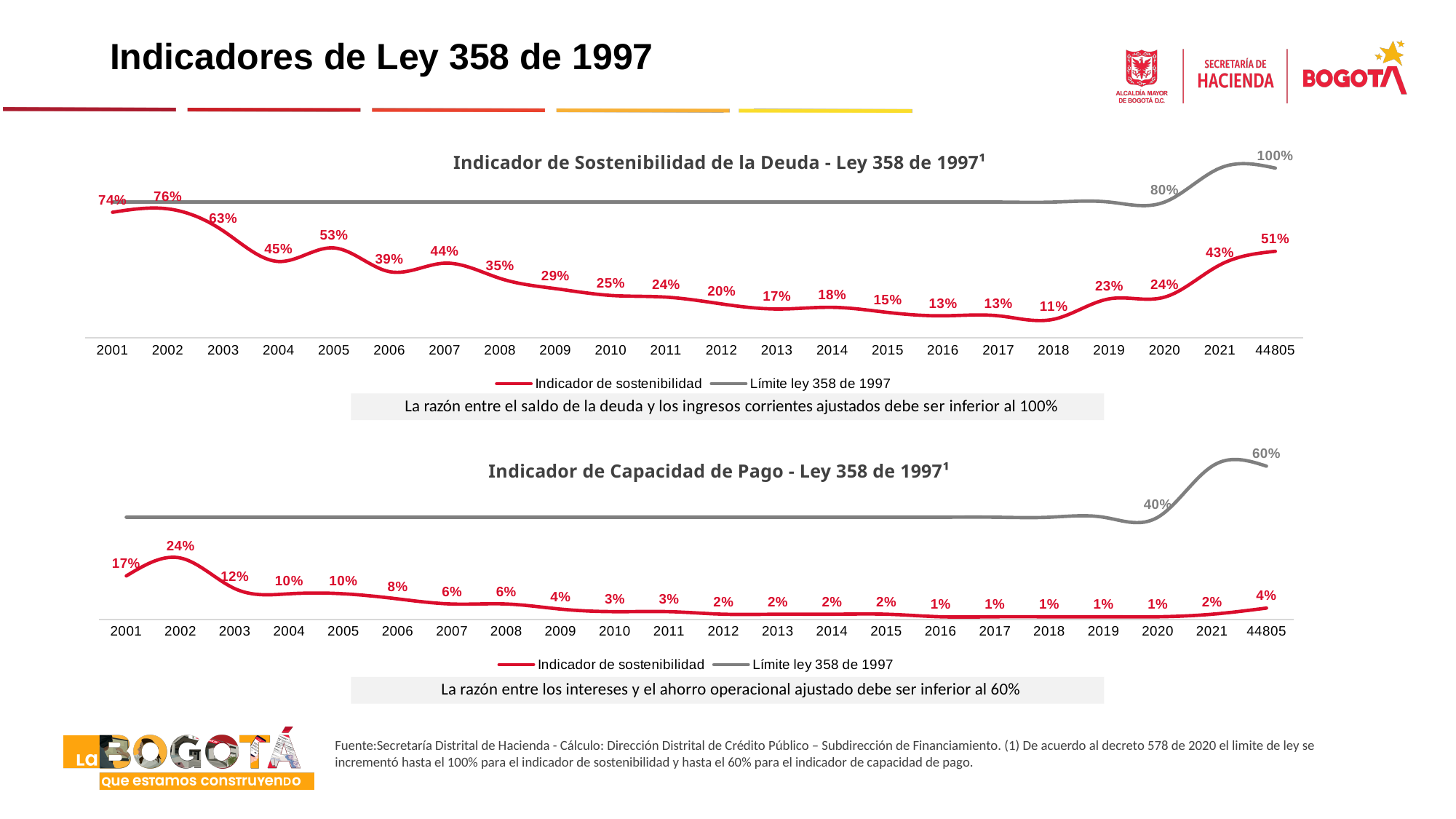
In the 'Indicador de Sostenibilidad de la Deuda' chart, which year has the lowest Indicador de sostenibilidad value? 2018 In the 'Indicador de Capacidad de Pago' chart, which is larger, the Indicador de sostenibilidad value for 2003 or for 2006? 2003 In the 'Indicador de Sostenibilidad de la Deuda' chart, what is the difference between the Indicador de sostenibilidad values for 2021 and 2020? 19% In the 'Indicador de Sostenibilidad de la Deuda' chart, which year has the highest Indicador de sostenibilidad value? 2002 In the 'Indicador de Capacidad de Pago' chart, how many points are plotted along the x axis? 22 In the 'Indicador de Sostenibilidad de la Deuda' chart, what is the value of the Indicador de sostenibilidad for 2005? 53% In the 'Indicador de Capacidad de Pago' chart, what is the Indicador de sostenibilidad value for 2002? 24% In the 'Indicador de Sostenibilidad de la Deuda' chart, how many series does the legend list? 2 What kind of chart is the 'Indicador de Capacidad de Pago' chart? Line chart In the 'Indicador de Sostenibilidad de la Deuda' chart, does the Indicador de sostenibilidad rise or fall from 2002 to 2018? Fall In the 'Indicador de Capacidad de Pago' chart, what is the last Límite ley 358 de 1997 value labelled on the right? 60% In the 'Indicador de Sostenibilidad de la Deuda' chart, what is the Límite ley 358 de 1997 value labelled at 2020? 80%